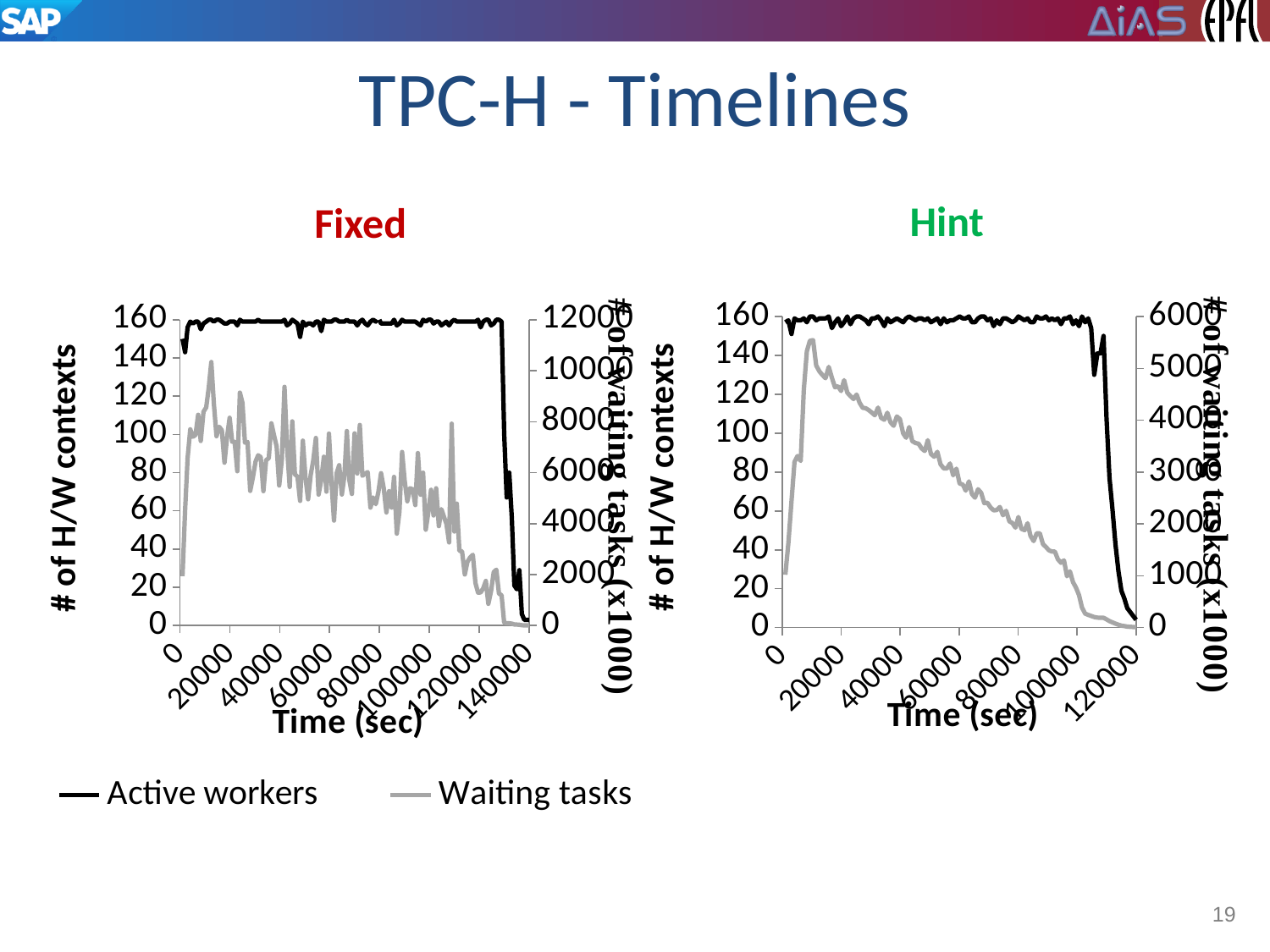
How many series does the legend list? 2 In the Fixed chart, is the value of Waiting tasks at 40000 sec greater or less than 4000? greater In the Hint chart, is the value of Active workers at 60000 sec greater or less than 140? greater What is the label of the x axis on both charts? Time (sec) In the Fixed chart, is the value of Active workers during the main part of the run greater or less than 140? greater In the Hint chart, do the Waiting tasks rise or fall along the x axis after their early peak? fall In the Fixed chart, do the Waiting tasks overall rise or fall from 20000 sec to the end of the run? fall What kind of chart is the Fixed chart? line chart What are the two series named in the legend? Active workers, Waiting tasks